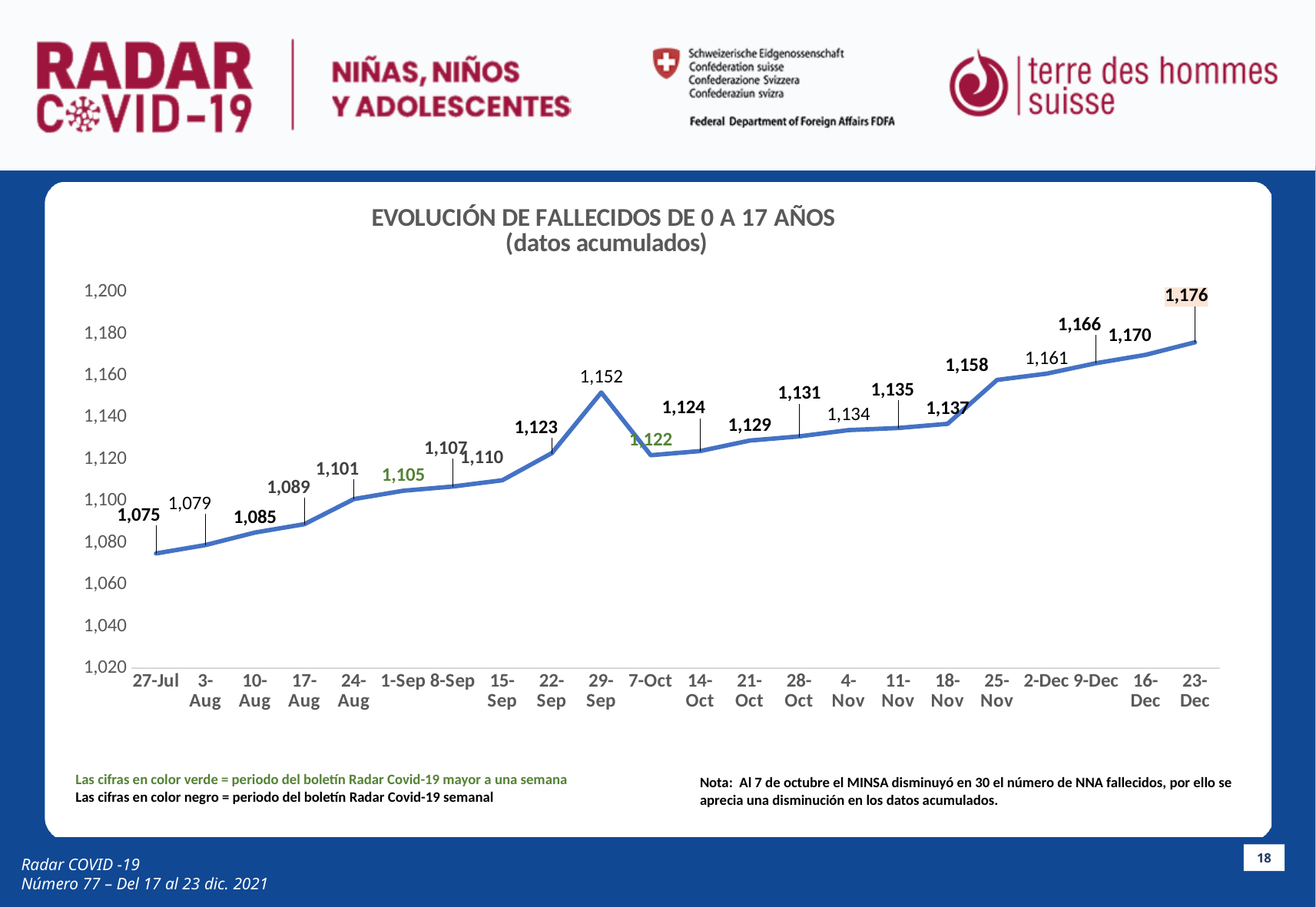
What is the cumulative number of deaths shown for 27-Jul? 1,075 What value is shown for 29-Sep? 1,152 Which date has the highest value on the chart? 23-Dec By how much did the value drop from 29-Sep to 7-Oct? 30 Do the values generally rise or fall from 27-Jul to 23-Dec? Rise What is the cumulative number of deaths shown for 23-Dec? 1,176 Which date has the lowest value on the chart? 27-Jul Which is larger, the value for 29-Sep or the value for 7-Oct? 29-Sep What value is shown for 25-Nov? 1,158 How many dates are plotted on the x axis? 22 What is the difference between the values for 23-Dec and 27-Jul? 101 What kind of chart is shown on the slide? Line chart